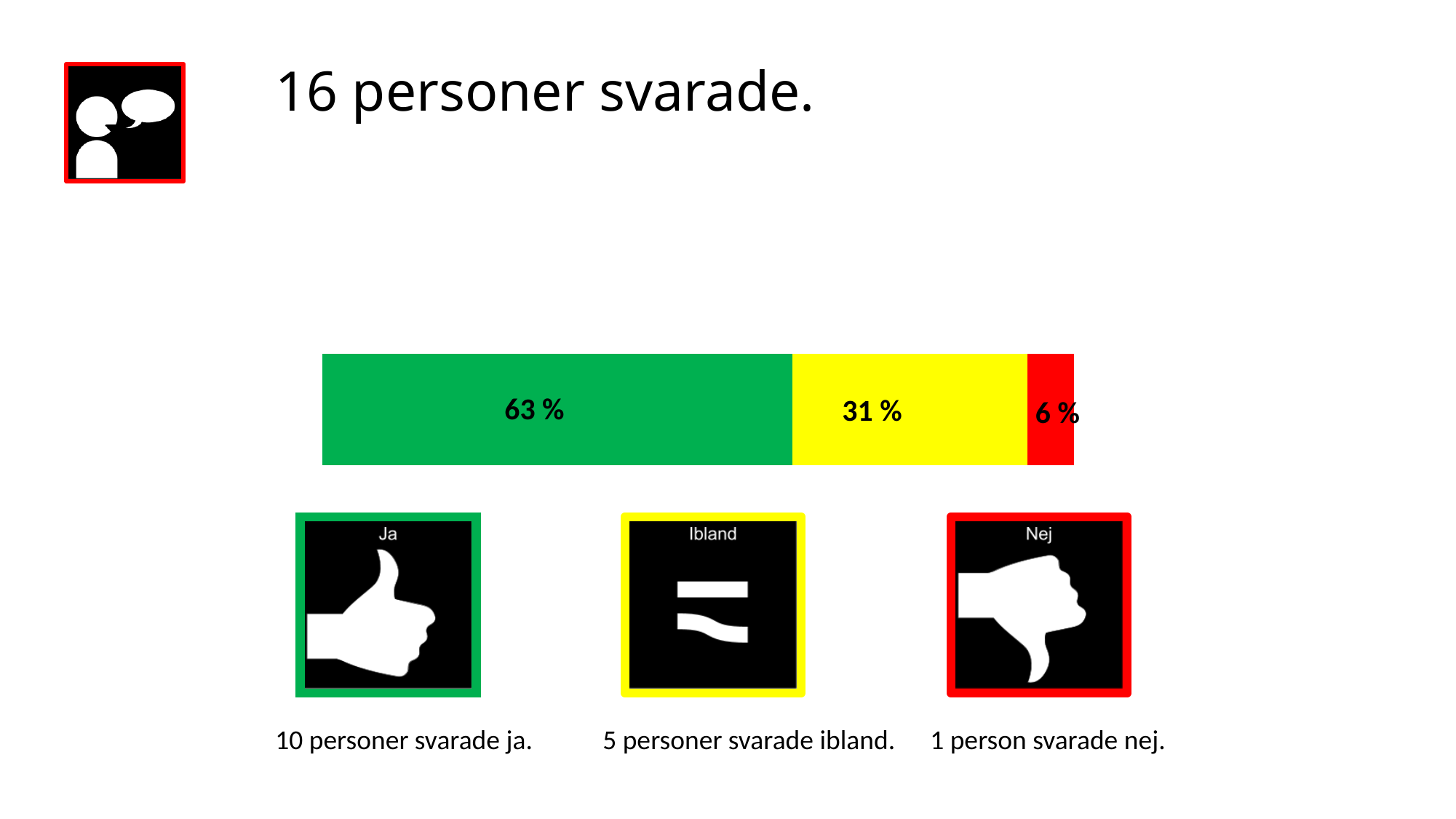
What percentage is shown for the yellow segment of the bar? 31 % Which response (Ja, Ibland or Nej) has the largest share of the bar? Ja What kind of chart is shown on the slide? bar chart How many people answered 'ja' according to the text below the chart? 10 What colour is the segment labelled 6 %? red How many segments does the stacked bar have? 3 Which is larger, the yellow segment or the red segment? the yellow segment What is the total of the three percentages shown on the bar? 100 % What percentage is shown for the red segment of the bar? 6 % What percentage is shown for the green segment of the bar? 63 % Which response (Ja, Ibland or Nej) has the smallest share of the bar? Nej What is the difference in percentage points between the green segment (63 %) and the yellow segment (31 %)? 32